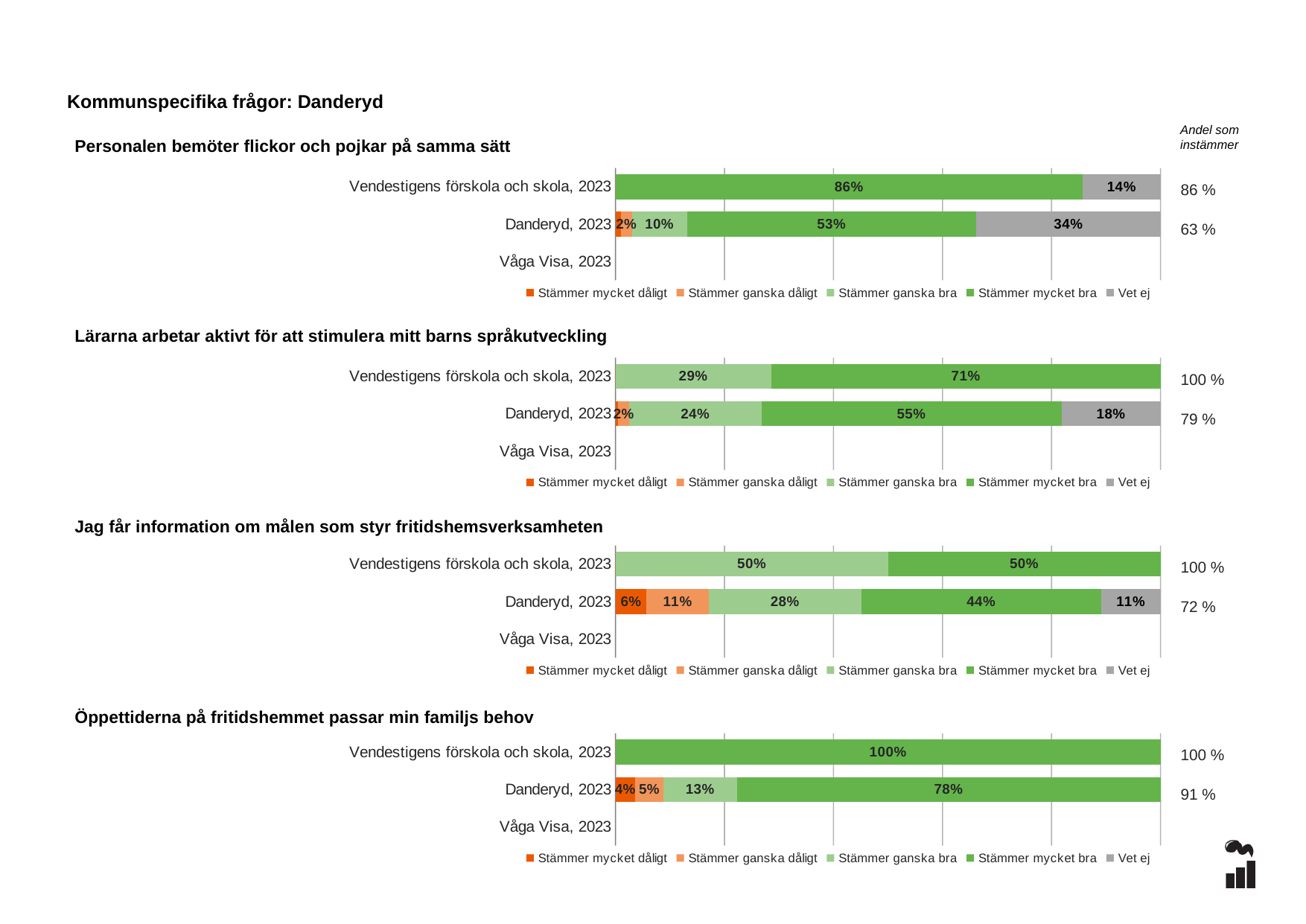
What kind of chart is 'Jag får information om målen som styr fritidshemsverksamheten'? Stacked bar chart In the chart 'Jag får information om målen som styr fritidshemsverksamheten', which is larger for Danderyd, 2023: 'Stämmer ganska bra' or 'Stämmer mycket bra'? Stämmer mycket bra In the chart 'Lärarna arbetar aktivt för att stimulera mitt barns språkutveckling', what is the 'Stämmer mycket bra' value for Danderyd, 2023? 55% In the chart 'Personalen bemöter flickor och pojkar på samma sätt', what is the 'Stämmer mycket bra' value for Vendestigens förskola och skola, 2023? 86% In the chart 'Jag får information om målen som styr fritidshemsverksamheten', what is the 'Stämmer mycket dåligt' value for Danderyd, 2023? 6% In the chart 'Lärarna arbetar aktivt för att stimulera mitt barns språkutveckling', what is the difference between the 'Stämmer mycket bra' values for Vendestigens förskola och skola, 2023 and Danderyd, 2023? 16% In the chart 'Öppettiderna på fritidshemmet passar min familjs behov', what is the 'Stämmer mycket bra' value for Vendestigens förskola och skola, 2023? 100% How many series does the legend list in the chart 'Personalen bemöter flickor och pojkar på samma sätt'? 5 In the chart 'Öppettiderna på fritidshemmet passar min familjs behov', what is the 'Andel som instämmer' shown for Danderyd, 2023? 91 % In the chart 'Personalen bemöter flickor och pojkar på samma sätt', what is the 'Vet ej' value for Danderyd, 2023? 34% How many categories are shown on the y axis of the chart 'Lärarna arbetar aktivt för att stimulera mitt barns språkutveckling'? 3 In the chart 'Öppettiderna på fritidshemmet passar min familjs behov', what is the 'Stämmer mycket bra' value for Danderyd, 2023? 78%